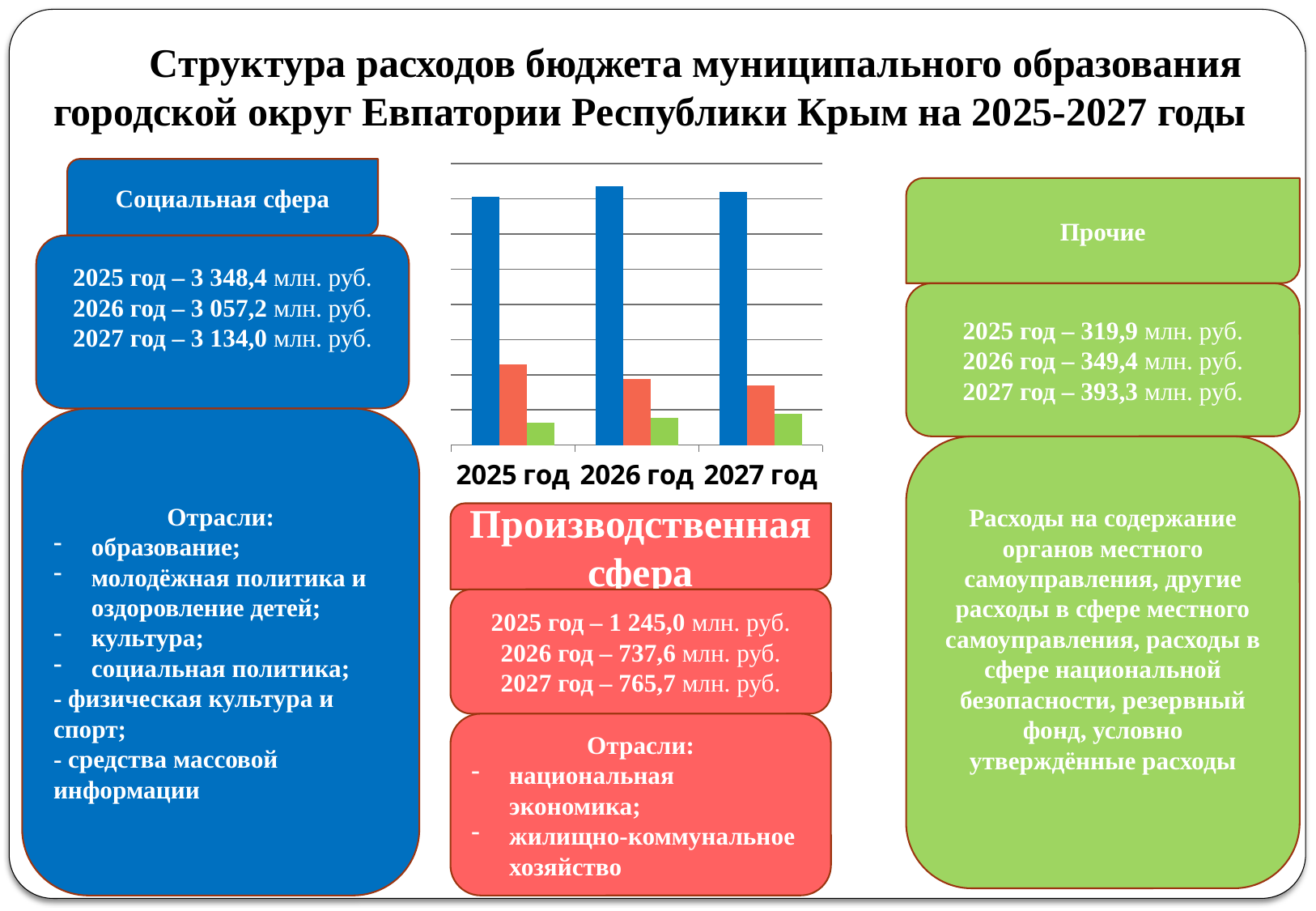
What are the category labels on the x axis of the chart? 2025 год, 2026 год, 2027 год Which colour bar is the tallest in every year group of the chart? blue Does the red bar rise or fall from 2025 год to 2026 год in the chart? fall In the chart, which is larger for 2027 год: the red bar or the green bar? the red bar In the chart, is the green bar for 2025 год larger or smaller than the blue bar for 2025 год? smaller In the chart, is the red bar larger for 2025 год or for 2026 год? 2025 год How many categories are shown on the x axis of the chart? 3 What kind of chart is shown in the middle of the slide? bar chart In which year is the red bar the tallest in the chart? 2025 год How many bars are plotted for each year in the chart? 3